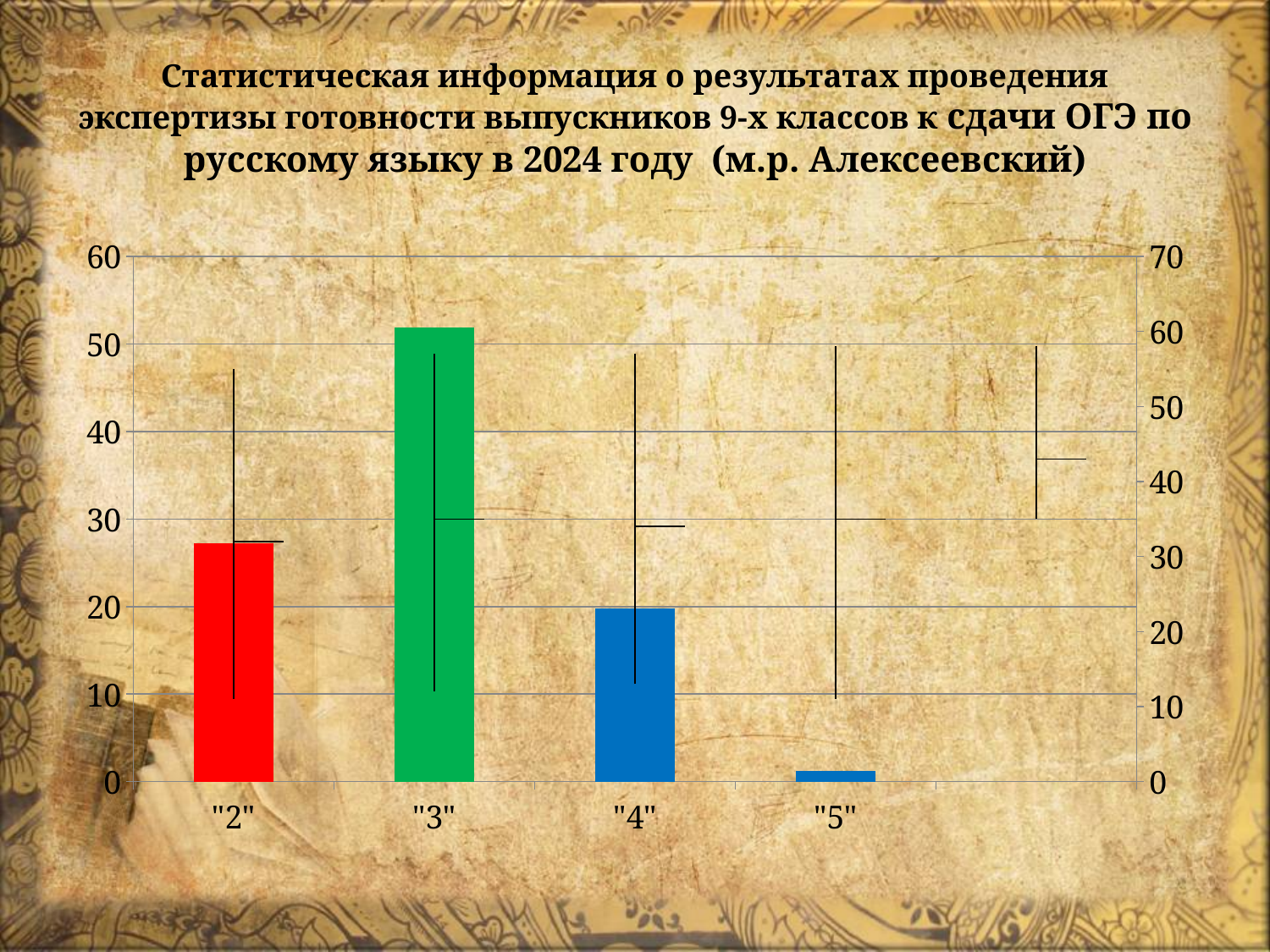
Which bar is taller, "2" or "4"? "2" On the left axis, is the value for "4" greater or less than 30? less Which category has the shortest bar? "5" On the left axis, is the value for "2" greater or less than 20? greater On the left axis, is the value for "5" greater or less than 10? less Which bar is taller, "3" or "2"? "3" How many labelled categories are shown on the x axis? 4 What kind of chart is shown on the slide? bar chart What colour is the bar for category "3"? green Which category has the tallest bar? "3"